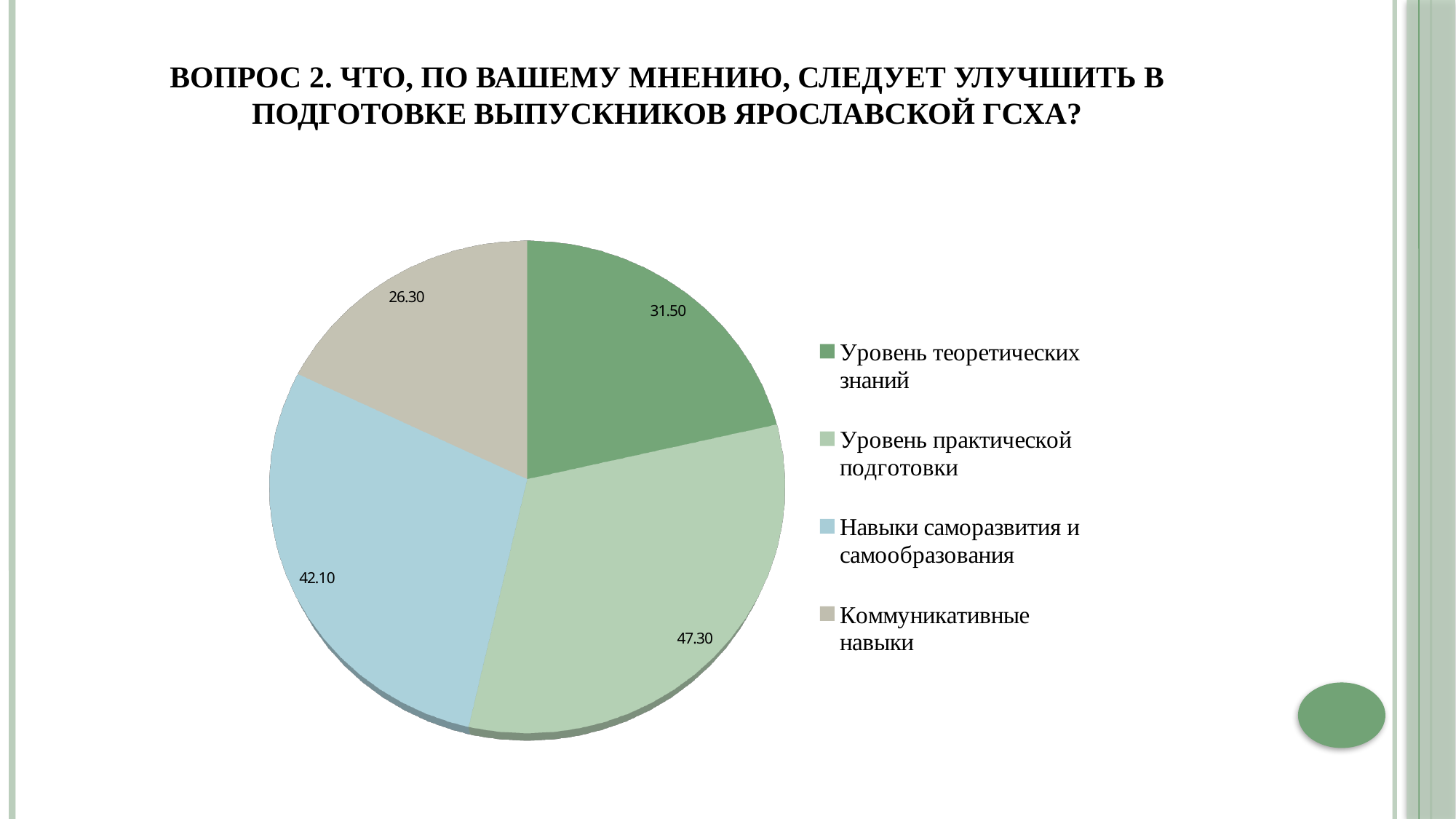
Which category has the largest slice? Уровень практической подготовки How many slices does the pie chart have? 4 What is the difference between the values for "Уровень практической подготовки" and "Навыки саморазвития и самообразования"? 5.20 What is the difference between the values for "Уровень теоретических знаний" and "Коммуникативные навыки"? 5.20 Which category has the smallest slice? Коммуникативные навыки What is the value for "Уровень практической подготовки"? 47.30 What is the value for "Навыки саморазвития и самообразования"? 42.10 What is the value for "Коммуникативные навыки"? 26.30 What is the value for "Уровень теоретических знаний"? 31.50 What type of chart is shown on the slide? pie chart Which category is shown in light blue? Навыки саморазвития и самообразования Which is larger: the value for "Уровень теоретических знаний" or the value for "Навыки саморазвития и самообразования"? Навыки саморазвития и самообразования